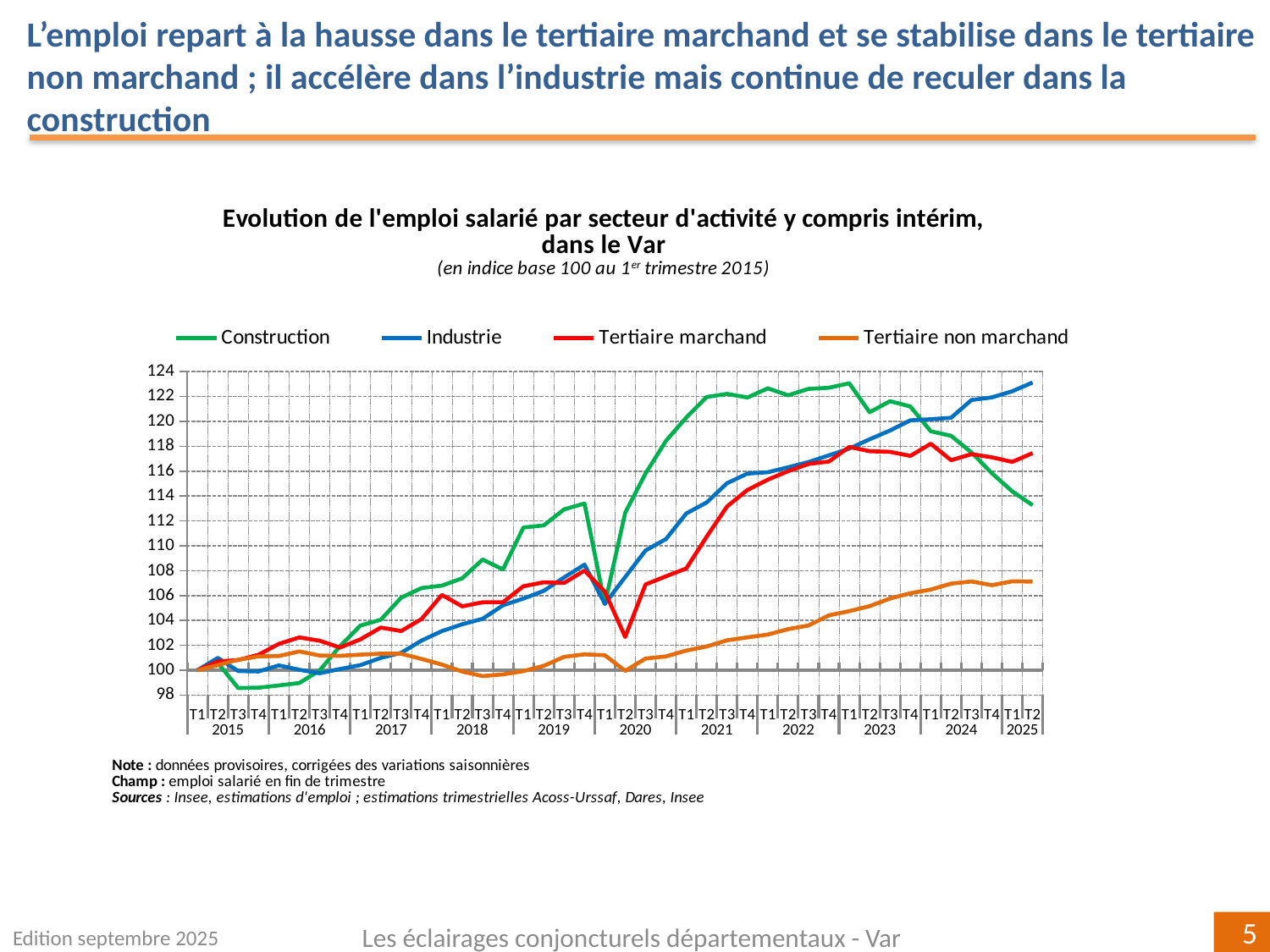
Does the Construction series rise or fall between T1 2023 and T2 2025? fall Is the value for Construction at T2 2025 greater or less than 116? less Is the value for Industrie at T1 2020 greater or less than 108? less What kind of chart is shown on the slide? line chart Which series has the highest value at T2 2025? Industrie Which series has the lowest value at T2 2025? Tertiaire non marchand How many series does the legend list? 4 At T2 2025, which is larger: Construction or Tertiaire marchand? Tertiaire marchand Is the value for Tertiaire marchand at T2 2020 greater or less than 104? less At T1 2021, which is larger: Construction or Industrie? Construction Which colour is used for the Tertiaire non marchand series? orange